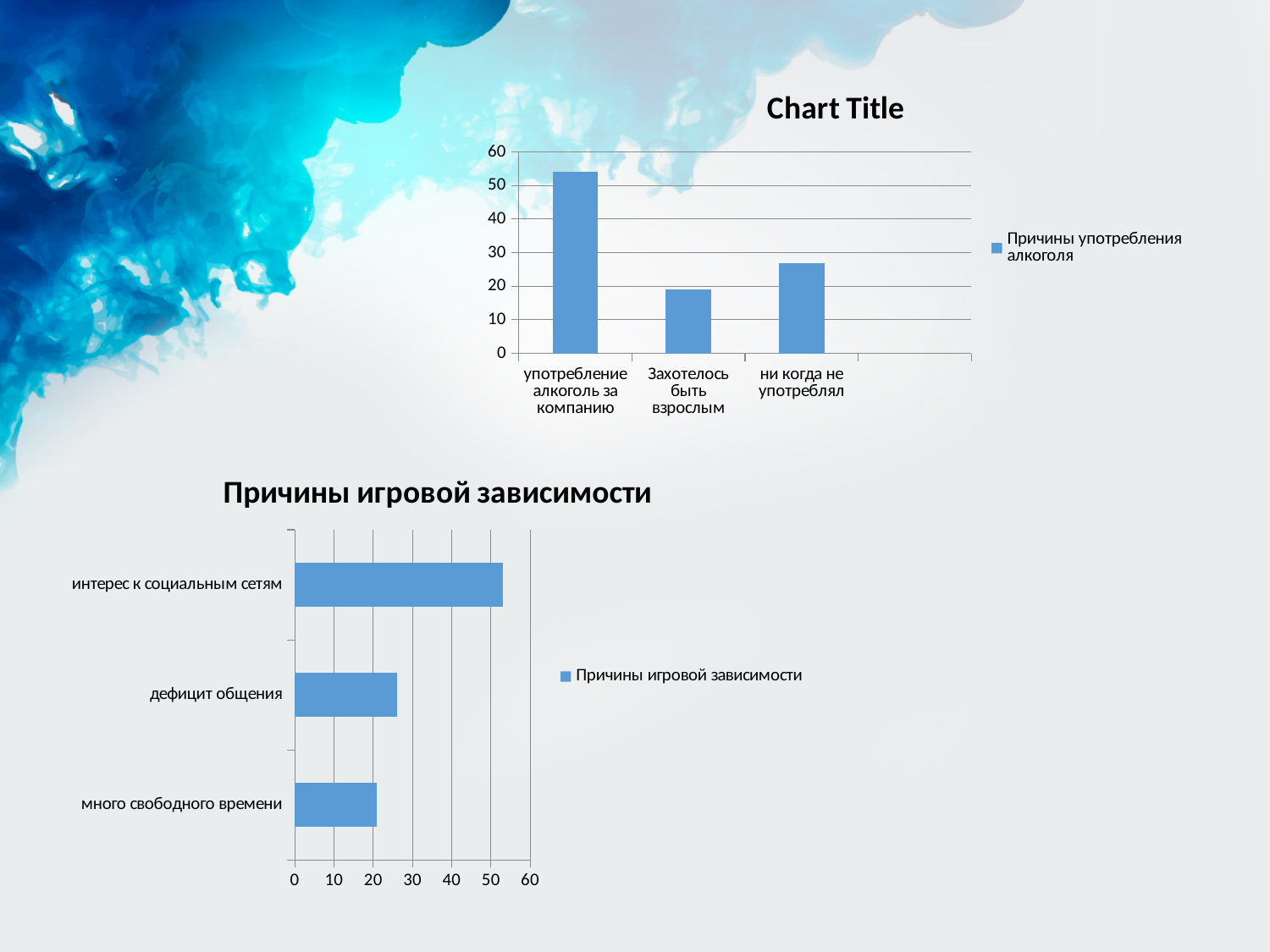
In the top chart titled "Chart Title", is the value for "употребление алкоголь за компанию" greater or less than 50? greater What is the legend entry of the top chart titled "Chart Title"? Причины употребления алкоголя How many series does the legend of the bottom chart "Причины игровой зависимости" list? 1 In the top chart titled "Chart Title", which is larger: the value for "ни когда не употреблял" or the value for "Захотелось быть взрослым"? ни когда не употреблял How many categories are shown in the top chart titled "Chart Title"? 3 In the top chart titled "Chart Title", which category has the lowest value? Захотелось быть взрослым In the bottom chart "Причины игровой зависимости", which category has the highest value? интерес к социальным сетям What kind of chart is the top chart titled "Chart Title"? bar chart In the bottom chart "Причины игровой зависимости", is the value for "много свободного времени" greater or less than 30? less In the bottom chart "Причины игровой зависимости", is the value for "интерес к социальным сетям" greater or less than 50? greater In the top chart titled "Chart Title", which category has the highest value? употребление алкоголь за компанию